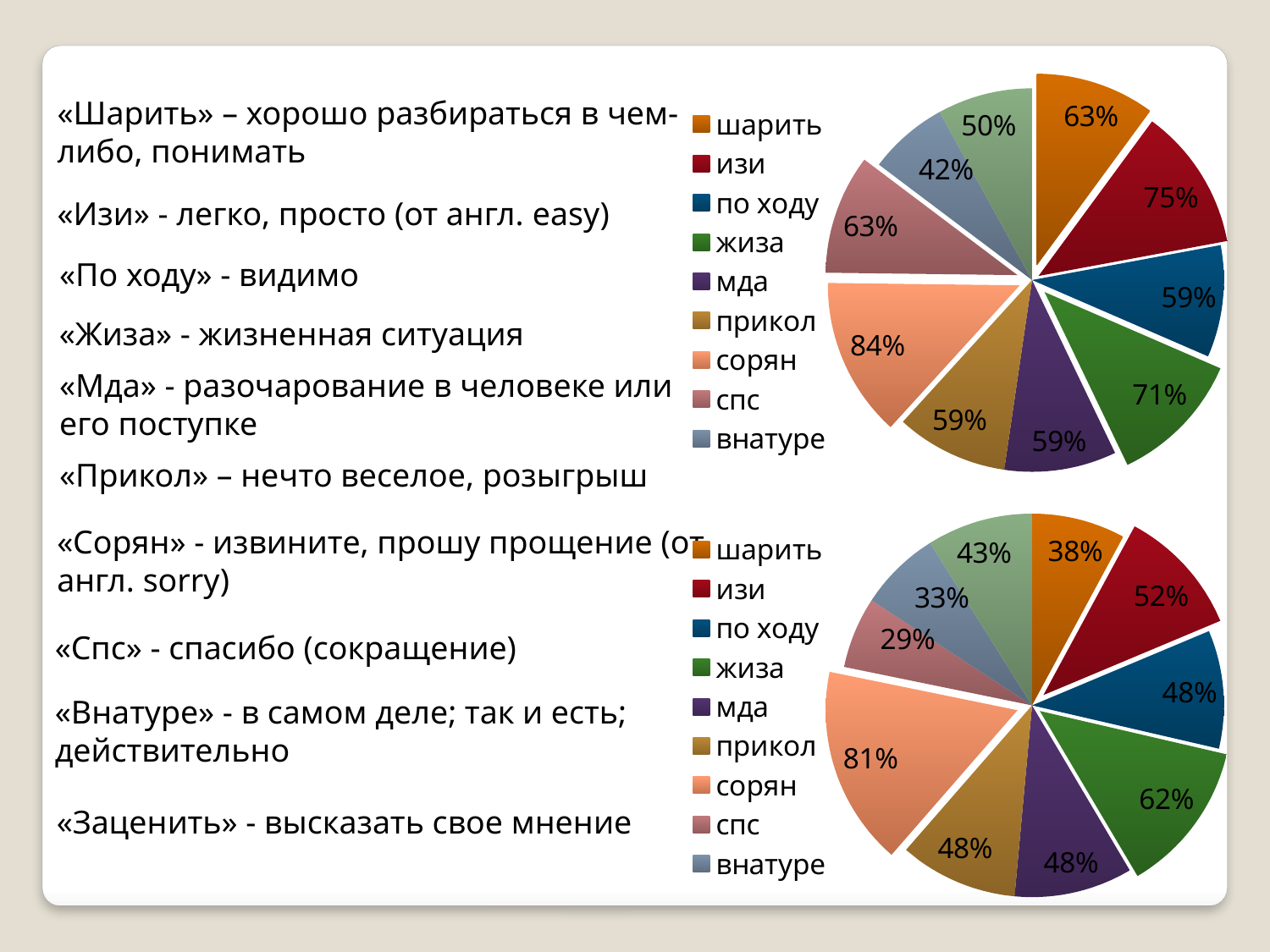
In the bottom pie chart, what value is shown for спс? 29% In the top pie chart, which legend category has the smallest slice? внатуре In the bottom pie chart, what value is shown for жиза? 62% In the top pie chart, which legend category has the largest slice? сорян In the bottom pie chart, what is the difference between the values for сорян and спс? 52% What type of chart is the bottom chart? pie chart In the top pie chart, what is the difference between the values for сорян and внатуре? 42% In the top pie chart, what value is shown for изи? 75% How many entries does the legend of the top chart list? 9 In the top pie chart, what value is shown for сорян? 84% In the bottom pie chart, which legend category has the largest slice? сорян In the bottom pie chart, which is larger, the value for изи or the value for шарить? изи